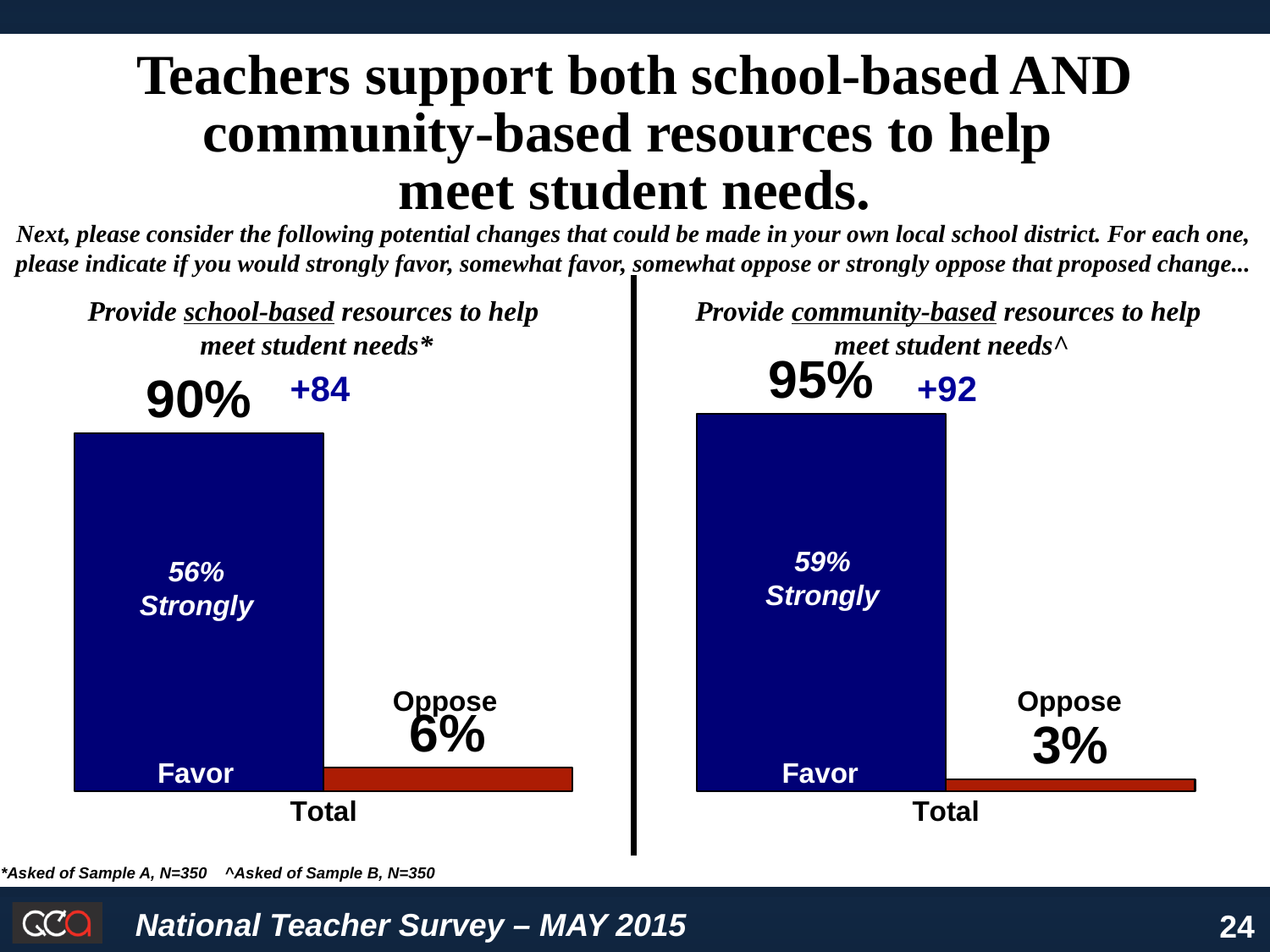
In the right chart (community-based resources), what percentage of teachers oppose the change? 3% In the left chart (school-based resources), what percentage of teachers oppose the change? 6% Which chart shows a higher Favor percentage, the school-based chart on the left or the community-based chart on the right? community-based (right) In the left chart (school-based resources), what percentage of teachers favor the change? 90% In the left chart (school-based resources), what percentage strongly favor the change? 56% In the right chart (community-based resources), what percentage strongly favor the change? 59% What kind of chart is used on this slide? bar chart In the left chart (school-based resources), what is the difference between the Favor and Oppose percentages? 84 In the right chart (community-based resources), what percentage of teachers favor the change? 95% What colour is the Oppose bar in each chart? red In the left chart (school-based resources), which is larger, Favor or Oppose? Favor In the right chart (community-based resources), what is the difference between the Favor and Oppose percentages? 92